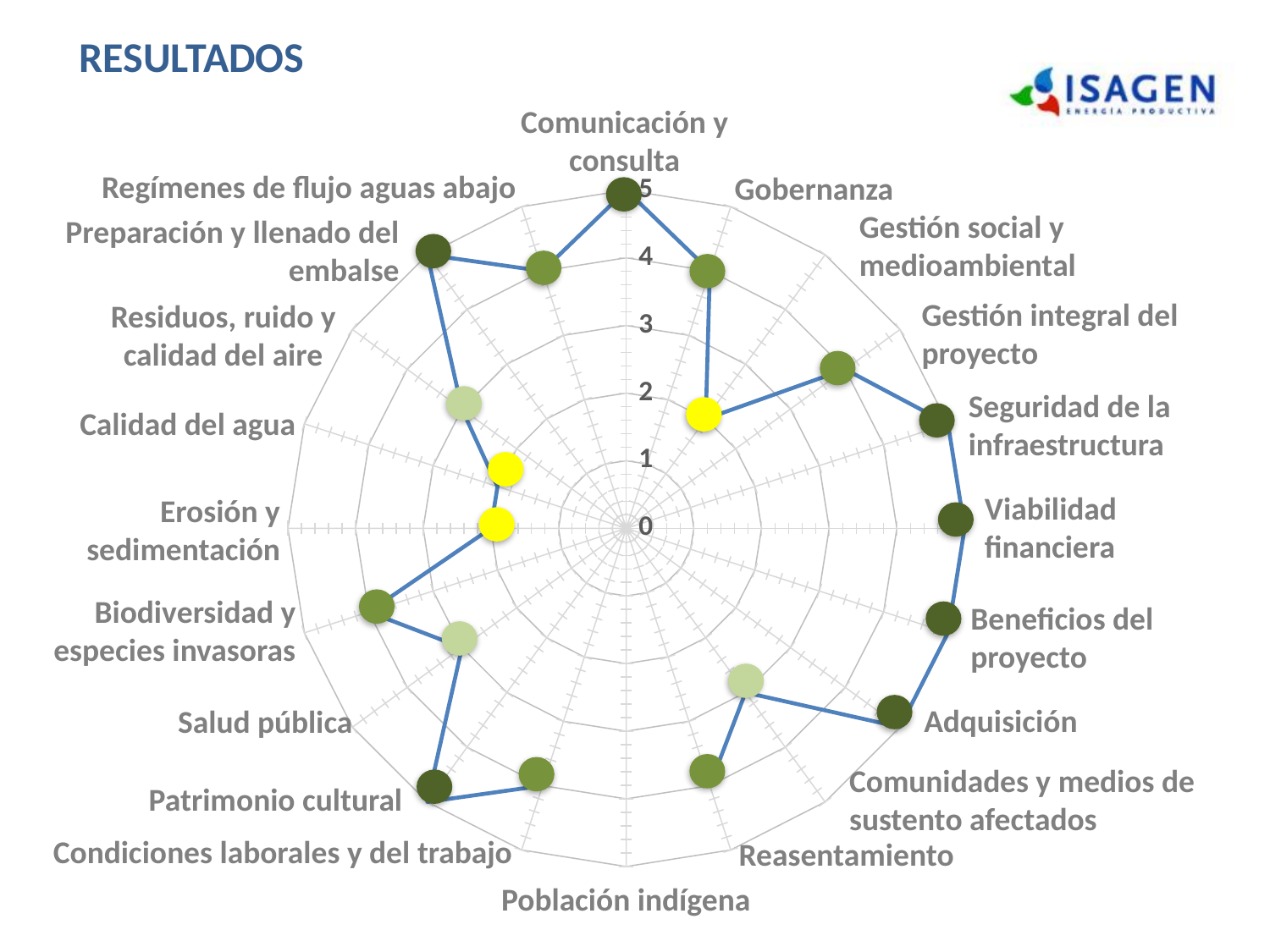
What is the value for Viabilidad financiera? 5 What is the value for Comunicación y consulta? 5 What is the value for Erosión y sedimentación? 2 What is the maximum value shown on the radar chart's axis scale? 5 What is the value for Beneficios del proyecto? 5 What is the value for Biodiversidad y especies invasoras? 4 Which is larger, the value for Comunicación y consulta or the value for Erosión y sedimentación? Comunicación y consulta What kind of chart is shown on the slide? Radar chart What is the value for Preparación y llenado del embalse? 5 What is the difference between the value for Viabilidad financiera and the value for Erosión y sedimentación? 3 Is the value for Erosión y sedimentación greater or less than 3? less How many categories (axes) does the radar chart have? 20